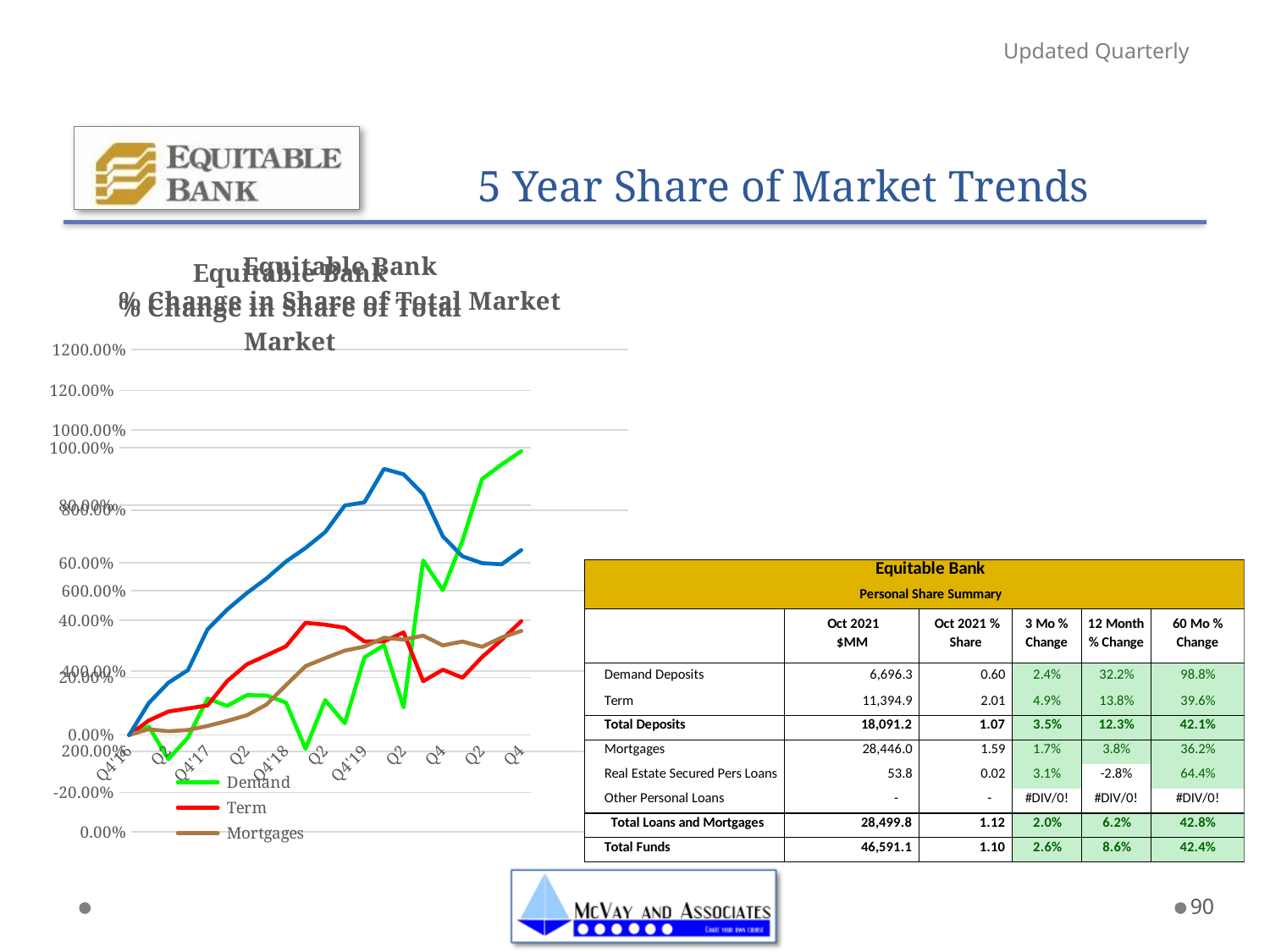
What kind of chart is shown on the slide? line chart What colour is the Demand line in the chart? green Does the Mortgages line generally rise or fall from left to right across the chart? rise At the final point (Q4), which is larger, the Demand value or the Mortgages value? Demand At the final point (Q4), is the value for Demand greater or less than 80.00%? greater At the final point (Q4), is the value for Mortgages greater or less than 60.00%? less Which series has the highest value at the final point (Q4) on the chart? Demand